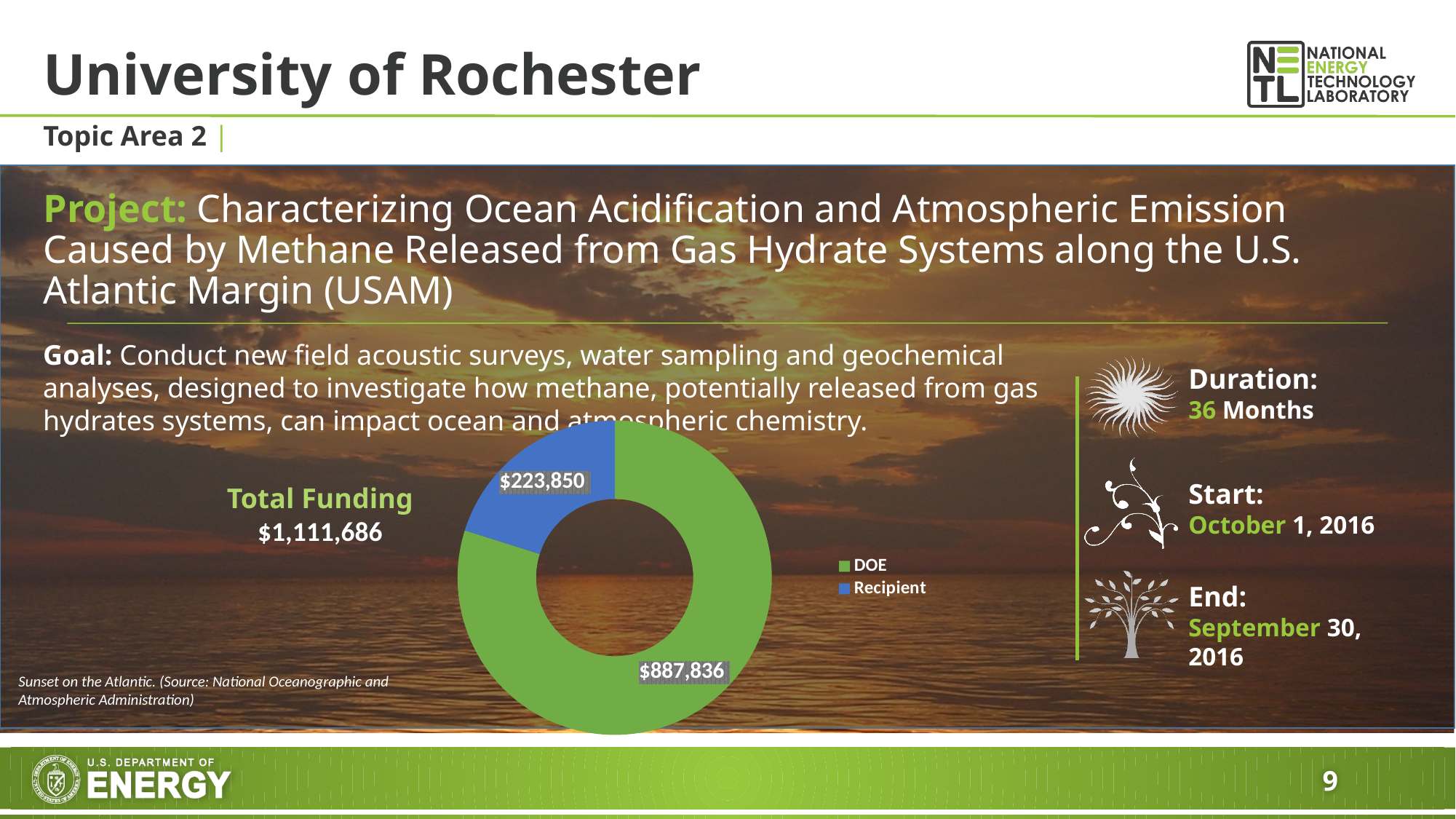
Is the DOE amount larger or smaller than the Recipient amount? Larger What is the difference between the DOE and Recipient funding amounts? $663,986 What is the Recipient funding amount shown in the chart? $223,850 How many entries does the chart legend list? 2 What is the DOE funding amount shown in the chart? $887,836 What colour represents Recipient in the chart? Blue How many slices does the chart have? 2 What kind of chart is shown on the slide? Pie (doughnut) chart Which funding source has the larger share in the chart? DOE What is the total funding shown next to the chart? $1,111,686 Which funding source has the smaller share in the chart? Recipient What colour represents DOE in the chart? Green